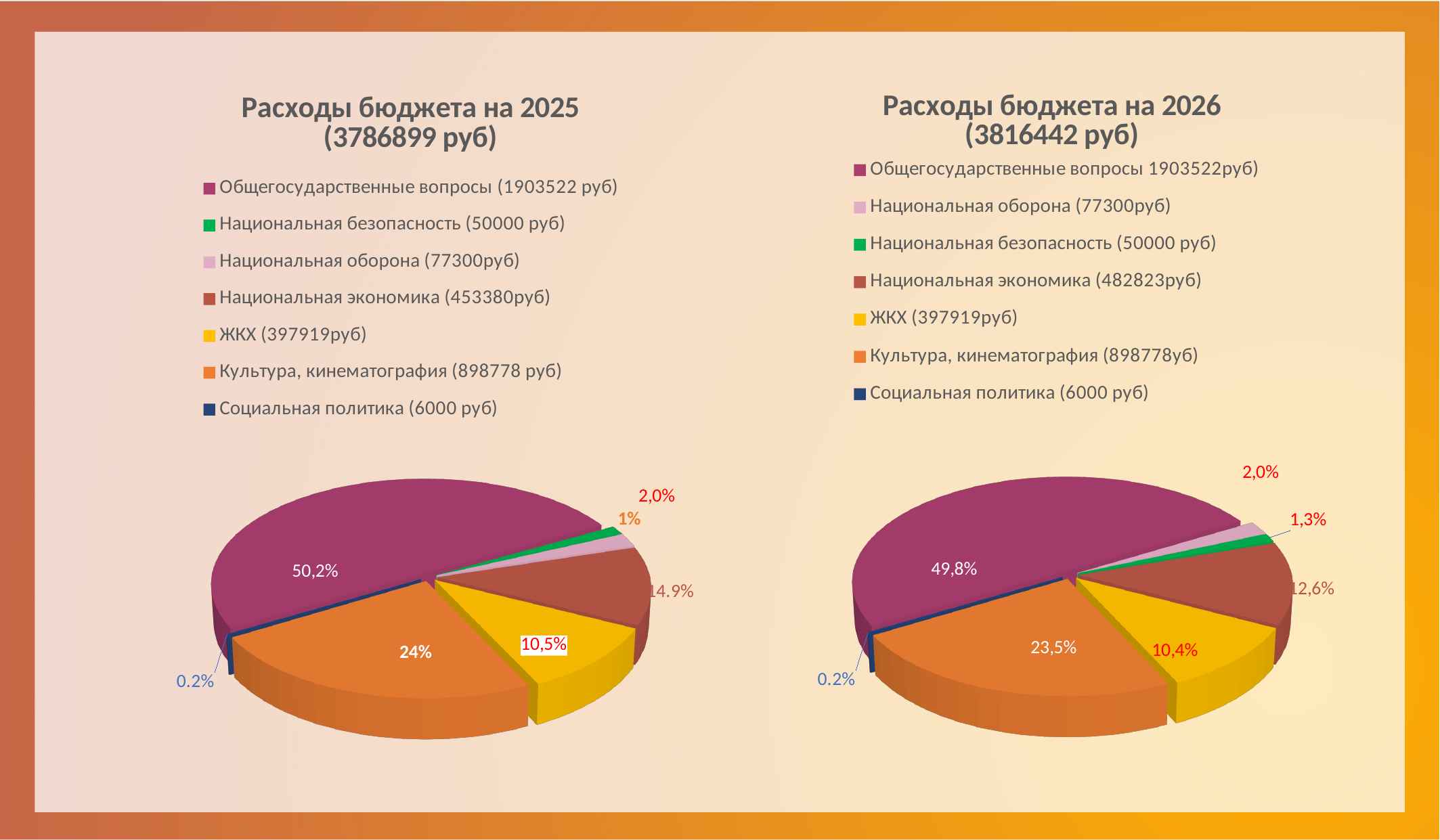
In the left chart (Расходы бюджета на 2025), what is the difference in percentage points between the Общегосударственные вопросы slice (50,2%) and the Культура, кинематография slice (24%)? 26,2 In the left chart (Расходы бюджета на 2025), what share is labelled on the Общегосударственные вопросы slice? 50,2% In the right chart (Расходы бюджета на 2026), what amount in rubles is given in the legend for Национальная экономика? 482823руб In the left chart (Расходы бюджета на 2025), what amount in rubles is given in the legend for Национальная экономика? 453380руб In the left chart (Расходы бюджета на 2025), which slice is larger: Культура, кинематография or Национальная экономика? Культура, кинематография In the right chart (Расходы бюджета на 2026), which category has the smallest slice? Социальная политика What kind of chart is the left chart, "Расходы бюджета на 2025"? Pie chart In the left chart (Расходы бюджета на 2025), what share is labelled on the ЖКХ slice? 10,5% In the left chart (Расходы бюджета на 2025), which category has the largest slice? Общегосударственные вопросы In the right chart (Расходы бюджета на 2026), what share is labelled on the Культура, кинематография slice? 23,5% How many categories does the legend of the right chart (Расходы бюджета на 2026) list? 7